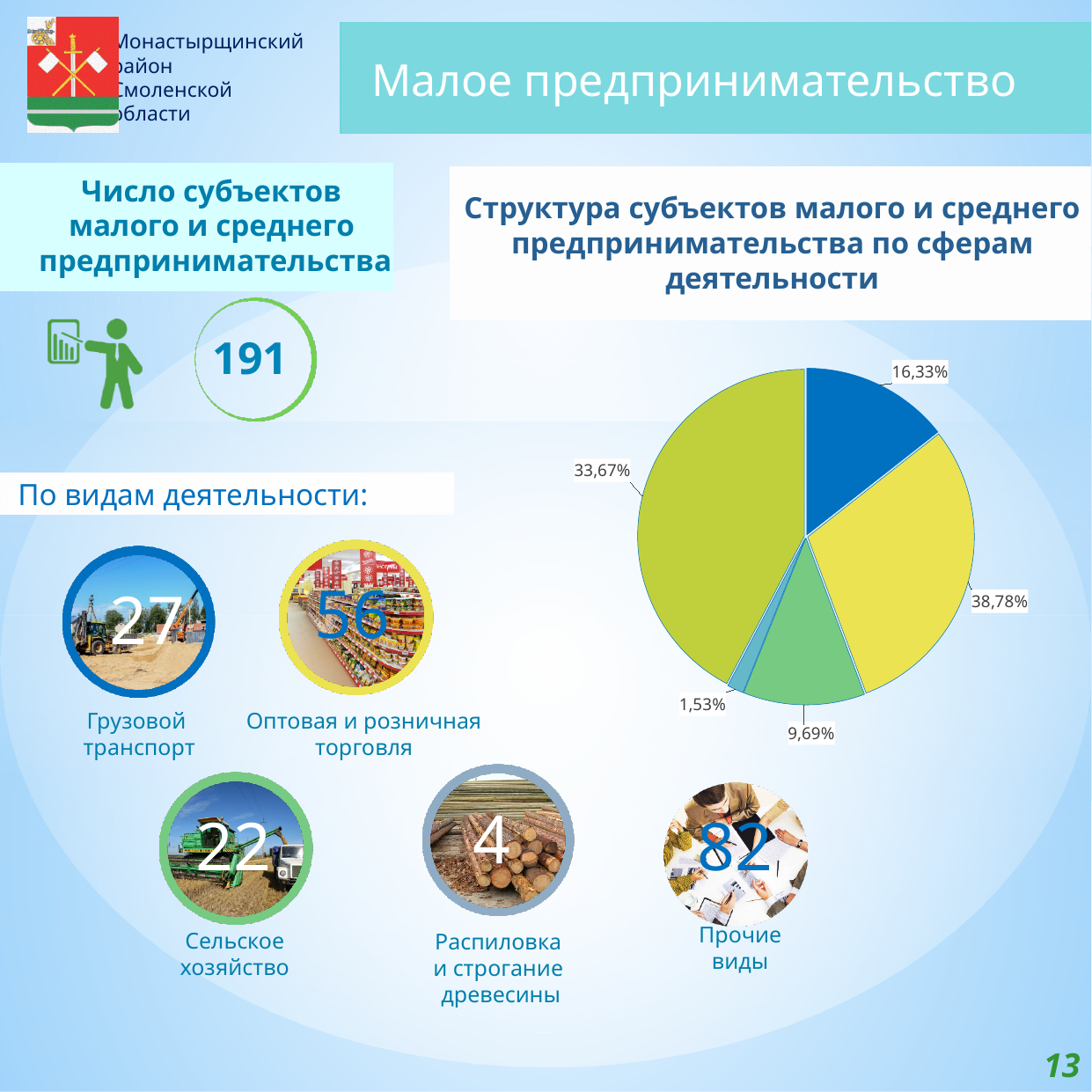
What is the difference in percentage points between the dark blue slice (16,33%) and the green slice (9,69%) of the pie chart? 6,64 What percentage is shown for the dark blue slice of the pie chart? 16,33% What is the smallest percentage shown on the pie chart? 1,53% Which slice of the pie chart is larger, the dark blue one or the green one? the dark blue one What percentage is shown for the green slice of the pie chart? 9,69% What percentage is shown for the yellow slice of the pie chart? 38,78% What is the largest percentage shown on the pie chart? 38,78% How many slices does the pie chart have? 5 What is the title of the pie chart on the slide? Структура субъектов малого и среднего предпринимательства по сферам деятельности What percentage is shown for the olive (yellow-green) slice of the pie chart? 33,67% What type of chart is shown under the title "Структура субъектов малого и среднего предпринимательства по сферам деятельности"? pie chart What is the difference in percentage points between the yellow slice (38,78%) and the olive slice (33,67%) of the pie chart? 5,11